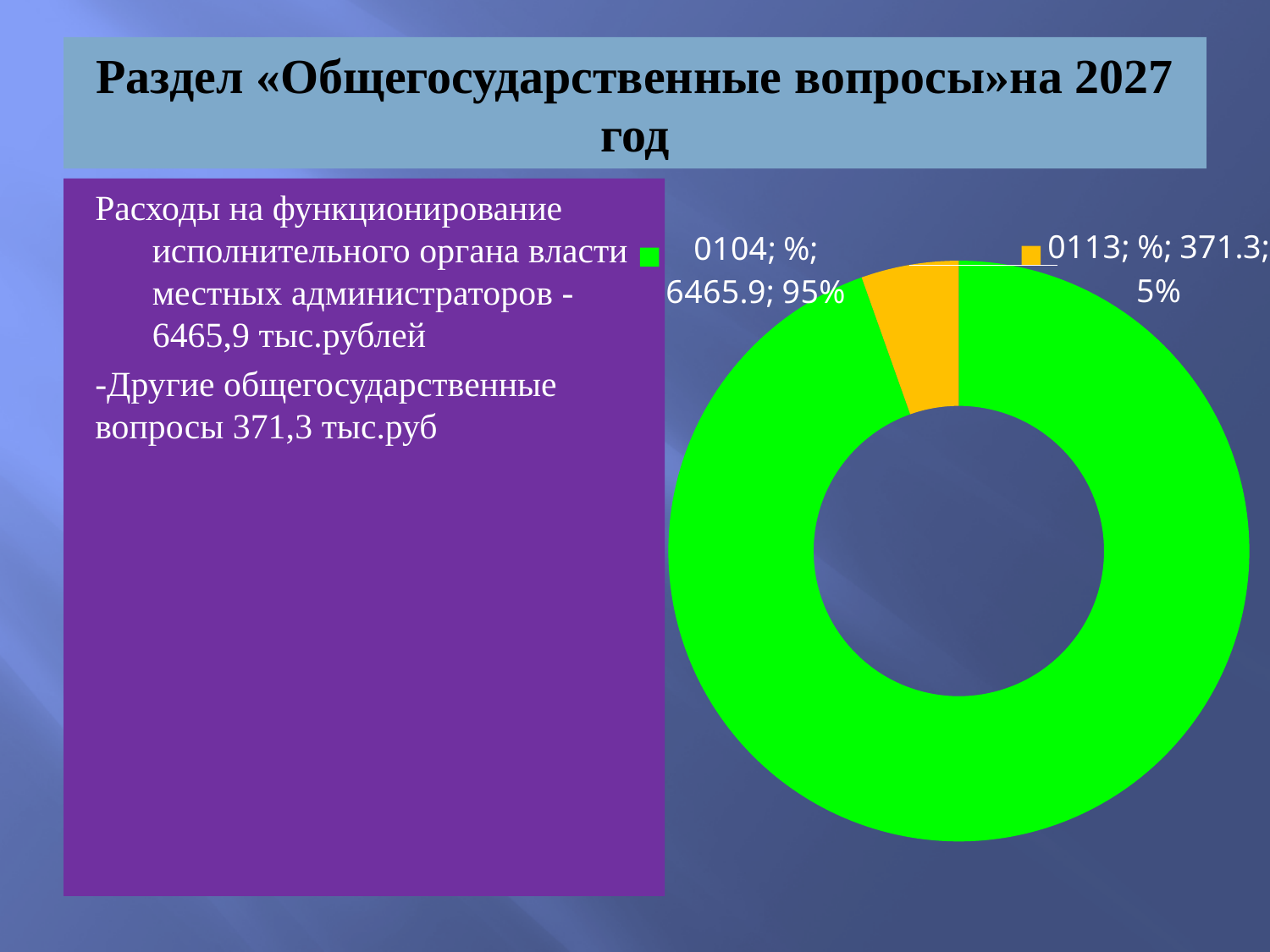
Which category has the largest slice in the doughnut chart? 0104 Which is larger in the doughnut chart, the value for 0104 or the value for 0113? 0104 How many slices does the doughnut chart have? 2 What colour is the slice for category 0113 in the doughnut chart? orange What colour is the slice for category 0104 in the doughnut chart? green What share of the doughnut chart does category 0113 represent? 5% What is the difference between the values for 0104 and 0113 in the doughnut chart? 6094.6 What share of the doughnut chart does category 0104 represent? 95% What value is shown for category 0104 in the doughnut chart? 6465.9 What kind of chart is shown on the slide? doughnut chart What value is shown for category 0113 in the doughnut chart? 371.3 Which category has the smallest slice in the doughnut chart? 0113